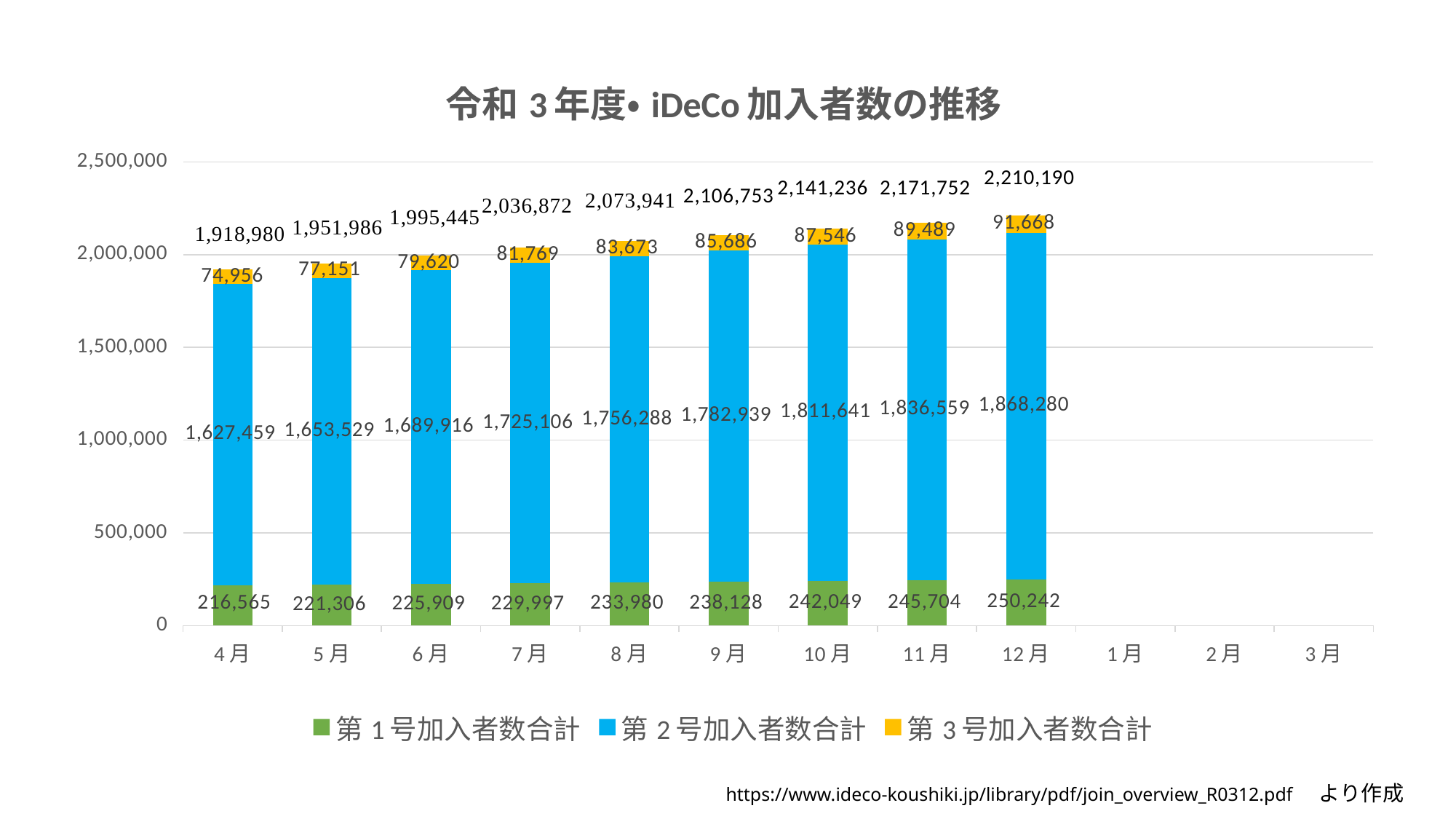
Do the total subscriber numbers rise or fall from 4月 to 12月? rise How many series does the legend list? 3 What is the value of 第2号加入者数合計 for 4月? 1,627,459 Which month with a plotted bar has the lowest total number of iDeCo subscribers? 4月 Which month has the highest total number of iDeCo subscribers? 12月 How much did 第1号加入者数合計 increase from 4月 to 12月? 33,677 What is the total of the stacked bar for 12月? 2,210,190 What is the value of 第3号加入者数合計 for 9月? 85,686 What is the value of 第1号加入者数合計 for 12月? 250,242 What is the difference between the total for 12月 and the total for 11月? 38,438 How many months have bars plotted on the chart? 9 In 8月, which is larger: 第1号加入者数合計 or 第3号加入者数合計? 第1号加入者数合計